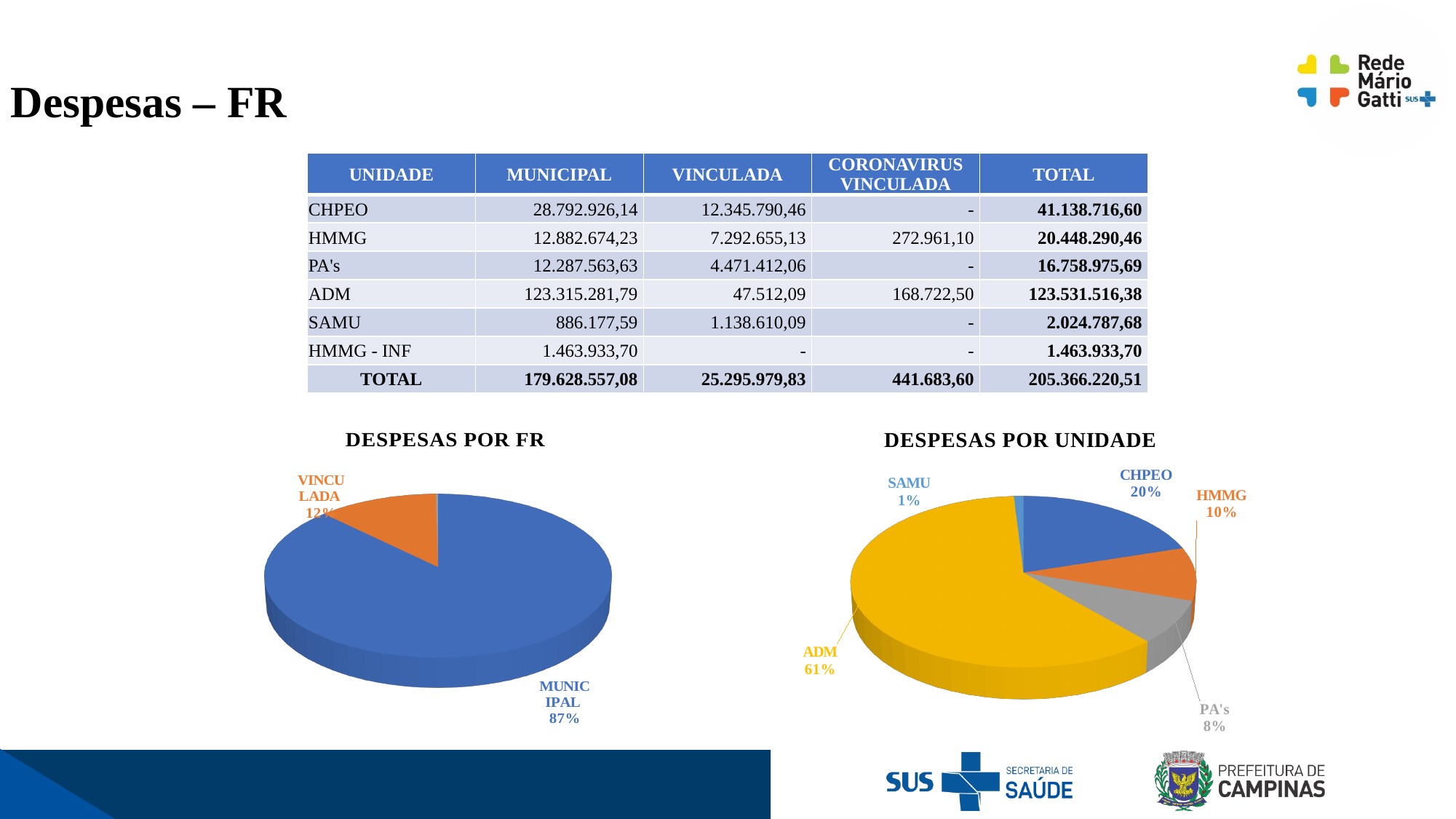
In the "DESPESAS POR UNIDADE" chart, what share does PA's have? 8% In the "DESPESAS POR UNIDADE" chart, which unit has the largest slice? ADM In the "DESPESAS POR UNIDADE" chart, what share does HMMG have? 10% How many slices does the "DESPESAS POR UNIDADE" chart have? 5 In the "DESPESAS POR FR" chart, which slice is larger, MUNICIPAL or VINCULADA? MUNICIPAL In the "DESPESAS POR UNIDADE" chart, how many percentage points larger is CHPEO's share than HMMG's share? 10 In the "DESPESAS POR UNIDADE" chart, which unit has the smallest slice? SAMU In the "DESPESAS POR UNIDADE" chart, what share does CHPEO have? 20% What is the title of the pie chart on the left of the slide? DESPESAS POR FR What kind of chart is the "DESPESAS POR UNIDADE" chart? pie chart